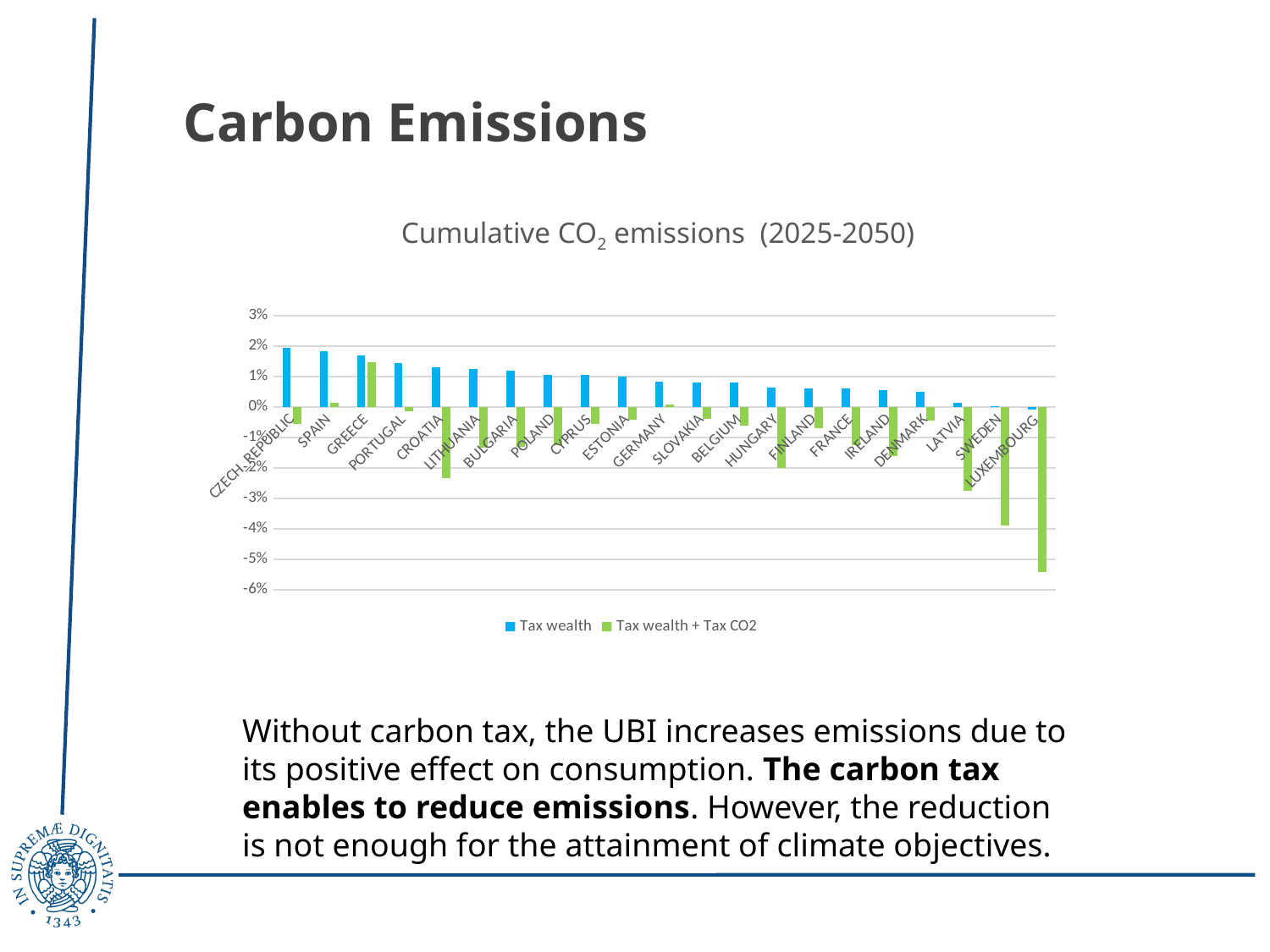
Which country has the highest value for the Tax wealth + Tax CO2 series? Greece What is the title of the chart? Cumulative CO2 emissions (2025-2050) Is the Tax wealth + Tax CO2 value for Sweden greater or less than -3%? less Which country has the lowest value for the Tax wealth + Tax CO2 series? Luxembourg How many countries are shown on the x axis? 21 Do the Tax wealth values rise or fall moving from left to right along the x axis? fall Which country has the highest value for the Tax wealth series? Czech Republic Is the Tax wealth + Tax CO2 value for Luxembourg greater or less than -5%? less What kind of chart is shown on the slide? bar chart How many series does the legend list? 2 Is the Tax wealth value for Czech Republic greater or less than 1%? greater Which has the larger Tax wealth value, Czech Republic or Hungary? Czech Republic